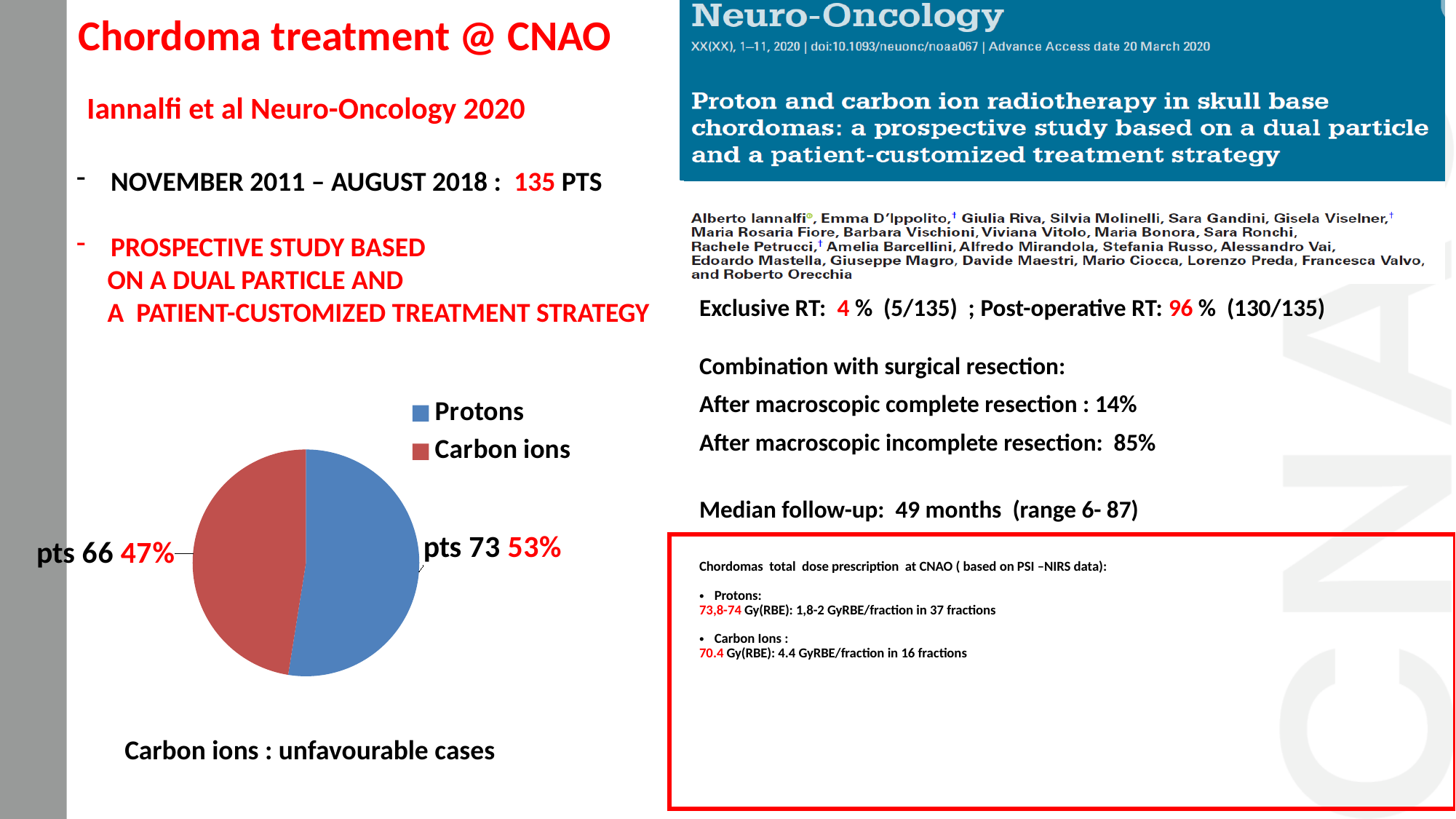
What colour is the carbon ions slice in the pie chart? red How many slices does the pie chart have? 2 Which slice of the pie chart is the smallest? Carbon ions Which group has more patients in the pie chart, protons or carbon ions? Protons How many patients were treated with carbon ions according to the pie chart? 66 Which slice of the pie chart is the largest? Protons What share of the pie chart do protons represent? 53% How many more patients were treated with protons than with carbon ions in the pie chart? 7 What kind of chart is shown on the slide? pie chart How many entries does the pie chart's legend list? 2 How many patients were treated with protons according to the pie chart? 73 What share of the pie chart do carbon ions represent? 47%